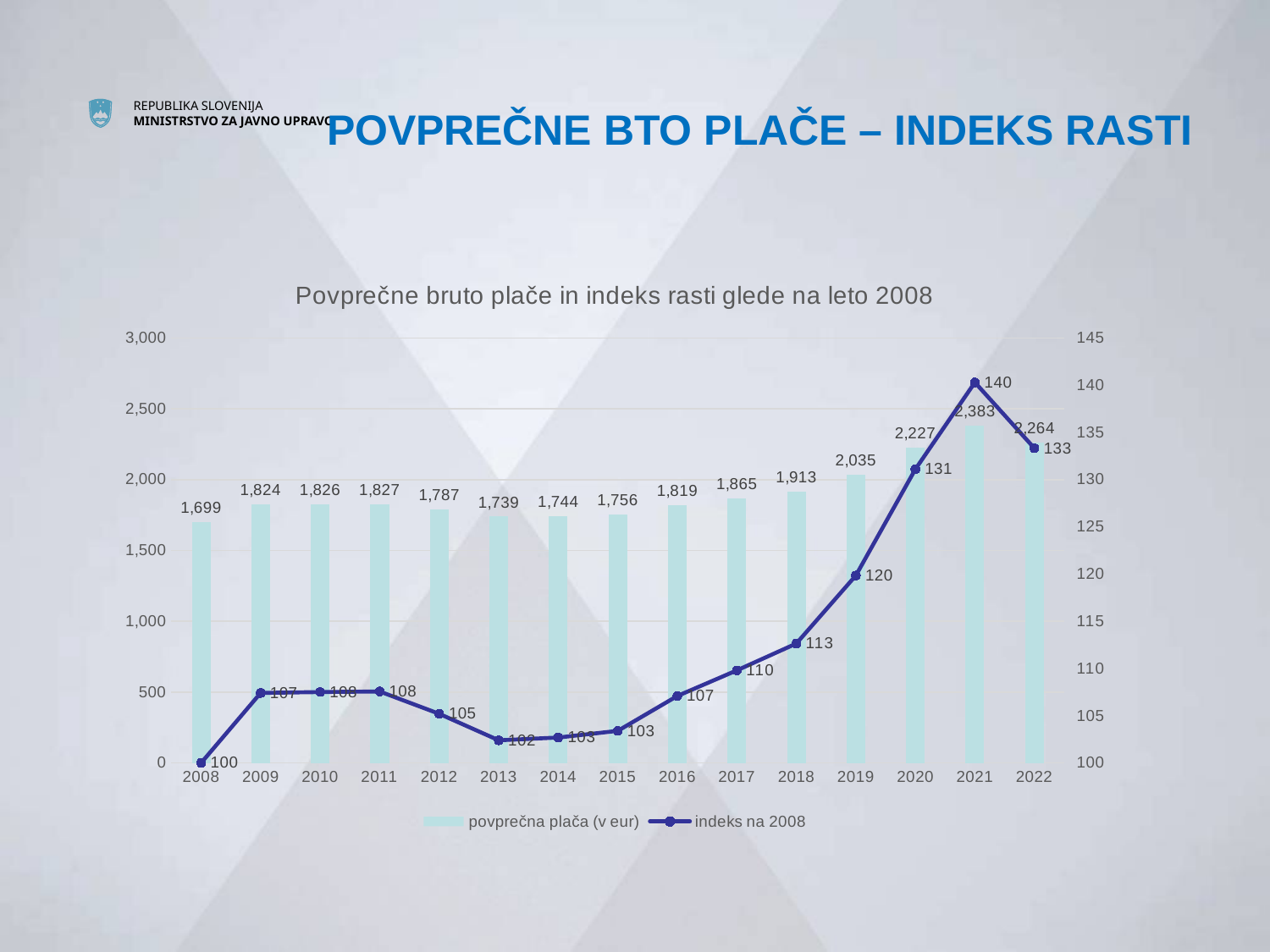
Which year has the lowest average gross salary bar? 2008 What kind of chart is used for the 'povprečna plača (v eur)' series? bar chart What is the value of the 'indeks na 2008' series for 2021? 140 Does the 'indeks na 2008' line rise or fall from 2015 to 2021? rise What is the difference between the average gross salary in 2021 and in 2022? 119 How many years are shown on the x axis? 15 How many series does the legend list? 2 What is the title of the chart? Povprečne bruto plače in indeks rasti glede na leto 2008 What is the average gross salary shown for 2020? 2,227 Which year has the highest average gross salary bar? 2021 What is the average gross salary (povprečna plača) shown for 2008? 1,699 Which year has the larger average gross salary, 2018 or 2019? 2019